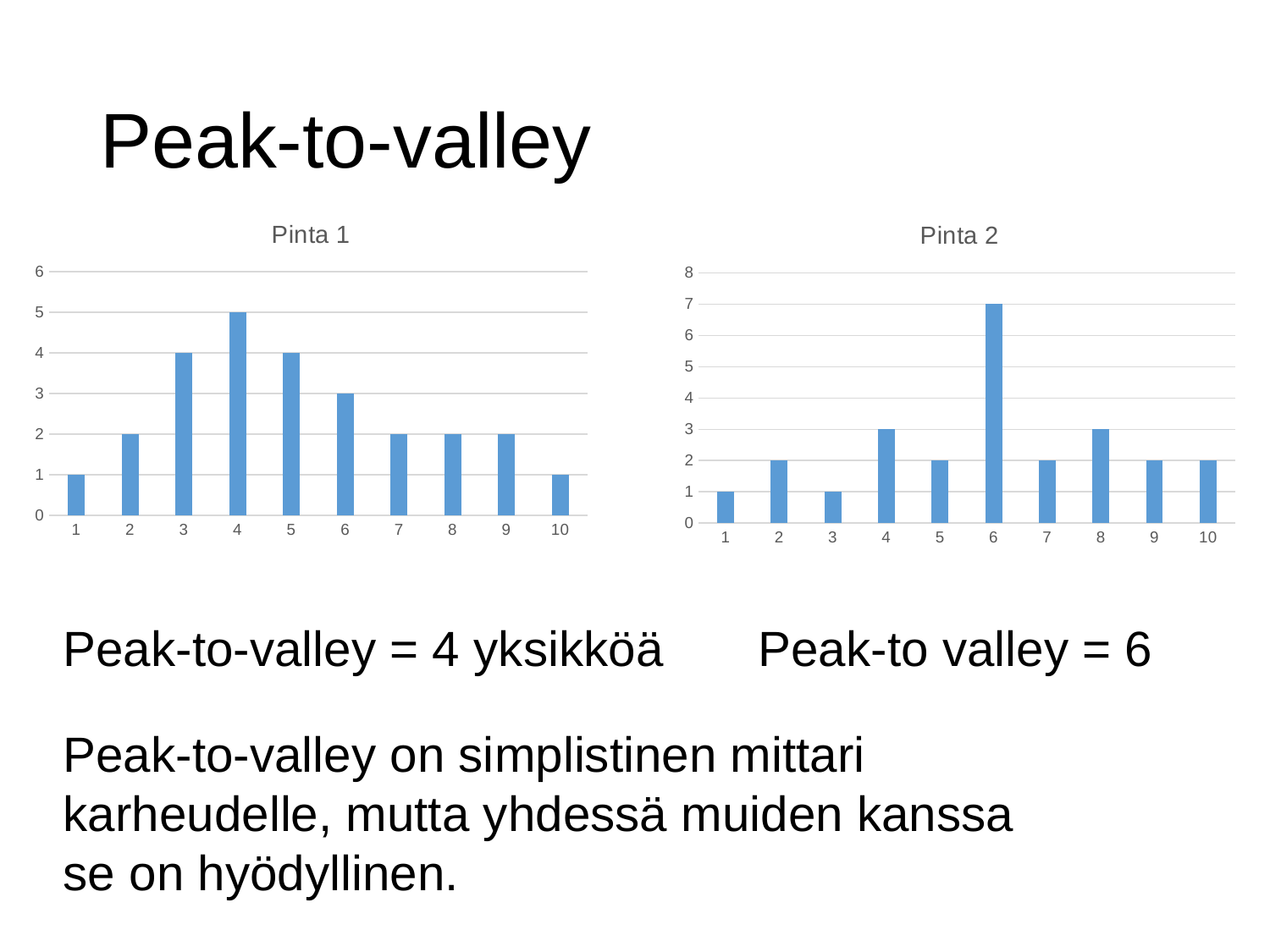
In the Pinta 2 chart, which category has the highest value? 6 In the Pinta 1 chart, which category has the highest value? 4 In the Pinta 1 chart, do the values rise or fall from category 4 to category 7? fall In the Pinta 1 chart, what is the difference between the values for categories 4 and 1? 4 What is the title of the chart on the right side of the slide? Pinta 2 In the Pinta 1 chart, what is the value for category 4? 5 What kind of chart is the Pinta 1 chart? bar chart In the Pinta 2 chart, what is the difference between the values for categories 6 and 3? 6 In the Pinta 1 chart, is the value for category 3 greater or less than 3? greater In the Pinta 2 chart, which is larger, the value for category 4 or the value for category 5? 4 In the Pinta 2 chart, what is the value for category 6? 7 How many categories are shown in the Pinta 2 chart? 10